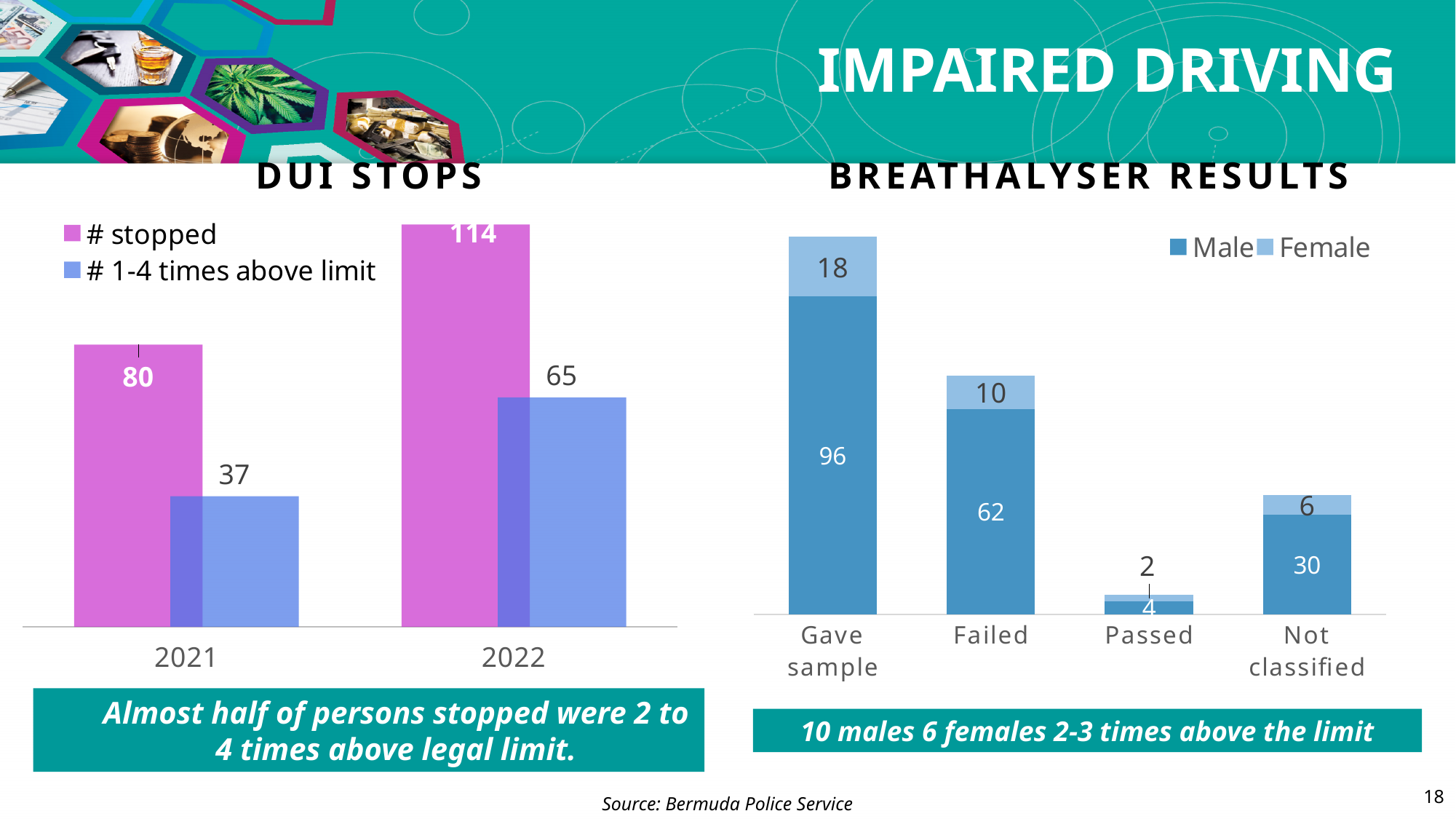
In the BREATHALYSER RESULTS chart, what is the total of the stacked bar for Not classified? 36 In the DUI STOPS chart, what is the value for # 1-4 times above limit in 2021? 37 In the DUI STOPS chart, what is the value for # stopped in 2022? 114 What kind of chart is the DUI STOPS chart? bar chart In the DUI STOPS chart, what is the difference between # stopped in 2022 and # stopped in 2021? 34 In the DUI STOPS chart, does the # 1-4 times above limit series rise or fall from 2021 to 2022? rise In the BREATHALYSER RESULTS chart, what is the Female value for Gave sample? 18 In the BREATHALYSER RESULTS chart, what is the Male value for Failed? 62 In the BREATHALYSER RESULTS chart, how many categories are shown on the x axis? 4 In the BREATHALYSER RESULTS chart, which category has the lowest total? Passed In the BREATHALYSER RESULTS chart, which is larger: the Male value for Not classified or the Female value for Gave sample? Male value for Not classified In the DUI STOPS chart, how many series does the legend list? 2